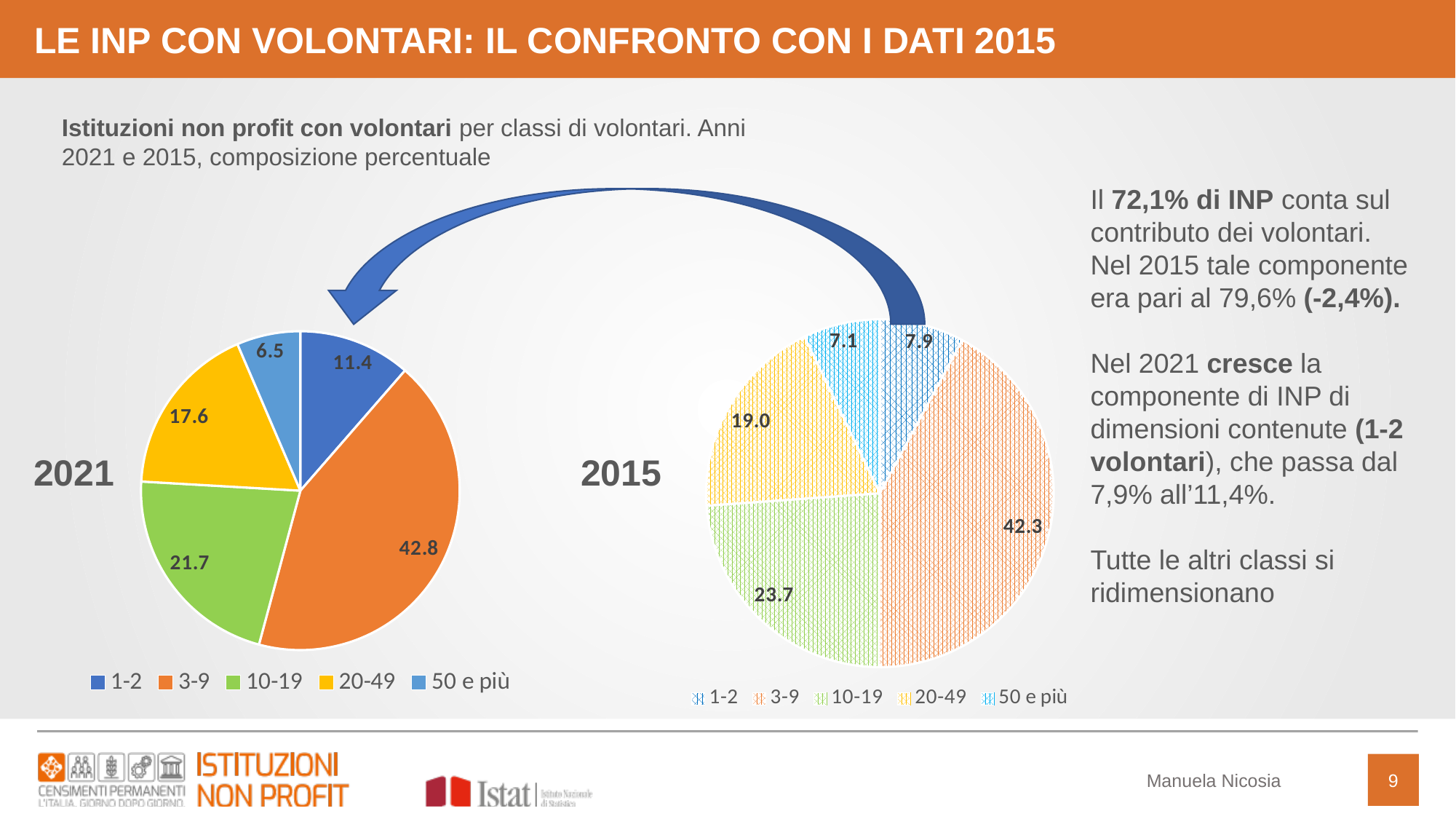
In the 2021 pie chart, what is the value for the 3-9 class? 42.8 What type of chart is used for the 2015 data? Pie chart In the 2021 pie chart, which is larger: the 10-19 class or the 20-49 class? 10-19 In the 2015 pie chart, which class has the smallest slice? 50 e più In the 2021 pie chart, what is the value for the 50 e più class? 6.5 How many slices does the 2021 pie chart have? 5 What is the difference between the 1-2 class value in the 2021 pie chart and in the 2015 pie chart? 3.5 In the 2015 pie chart, what is the value for the 20-49 class? 19.0 How many entries does the legend of the 2015 pie chart list? 5 In the 2021 pie chart, which class has the largest slice? 3-9 In the 2015 pie chart, what is the difference between the 10-19 class and the 20-49 class? 4.7 In the 2015 pie chart, what is the value for the 1-2 class? 7.9